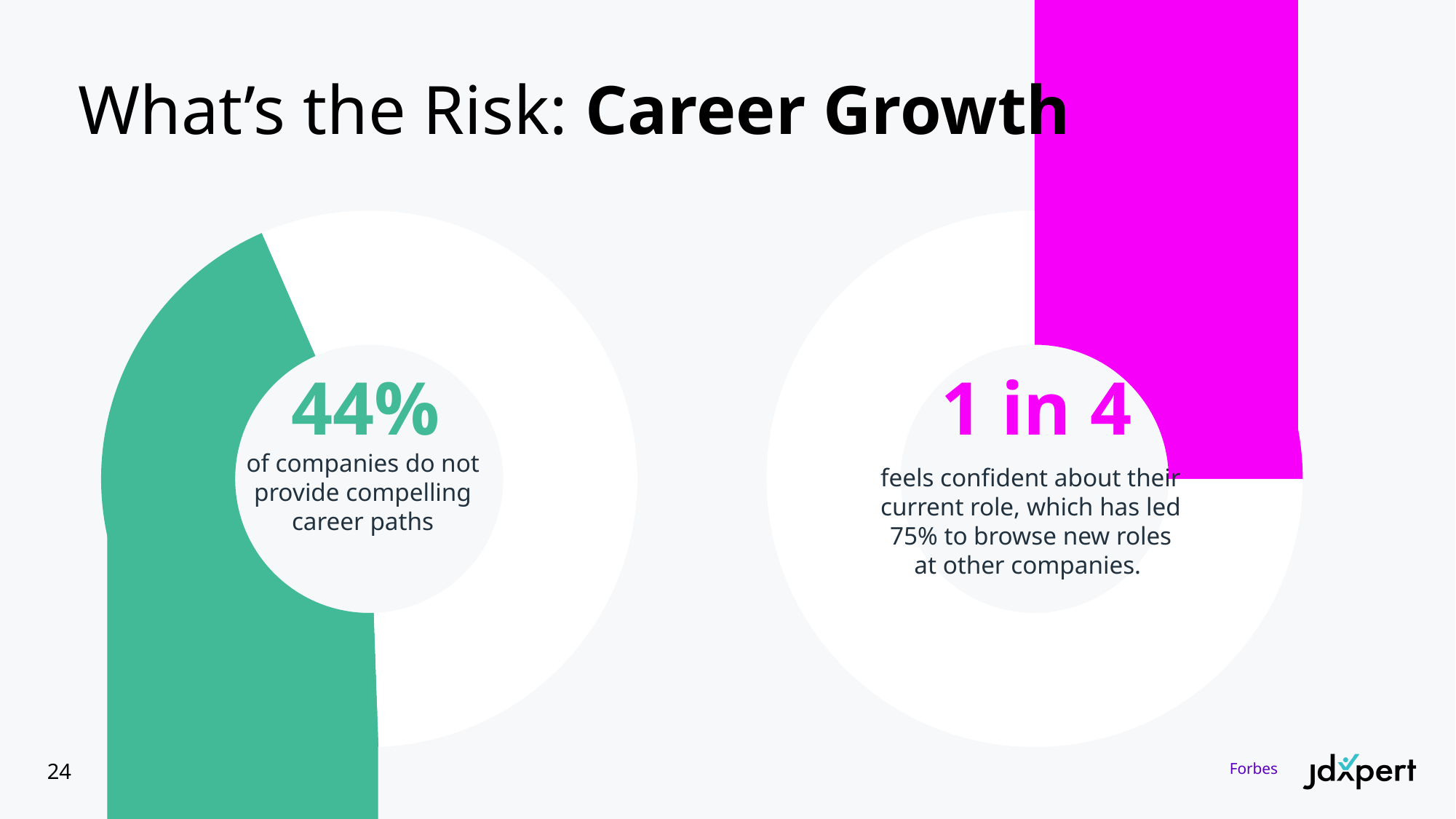
On the right chart, what proportion of people feels confident about their current role? 1 in 4 On the left chart, what colour is the segment representing the 44% value? Green On the right chart, what percentage has been led to browse new roles at other companies? 75% What is the title of the slide containing the two charts? What's the Risk: Career Growth On the left chart, what percentage of companies do not provide compelling career paths? 44% On the left chart, is the 44% segment more or less than half of the ring? Less